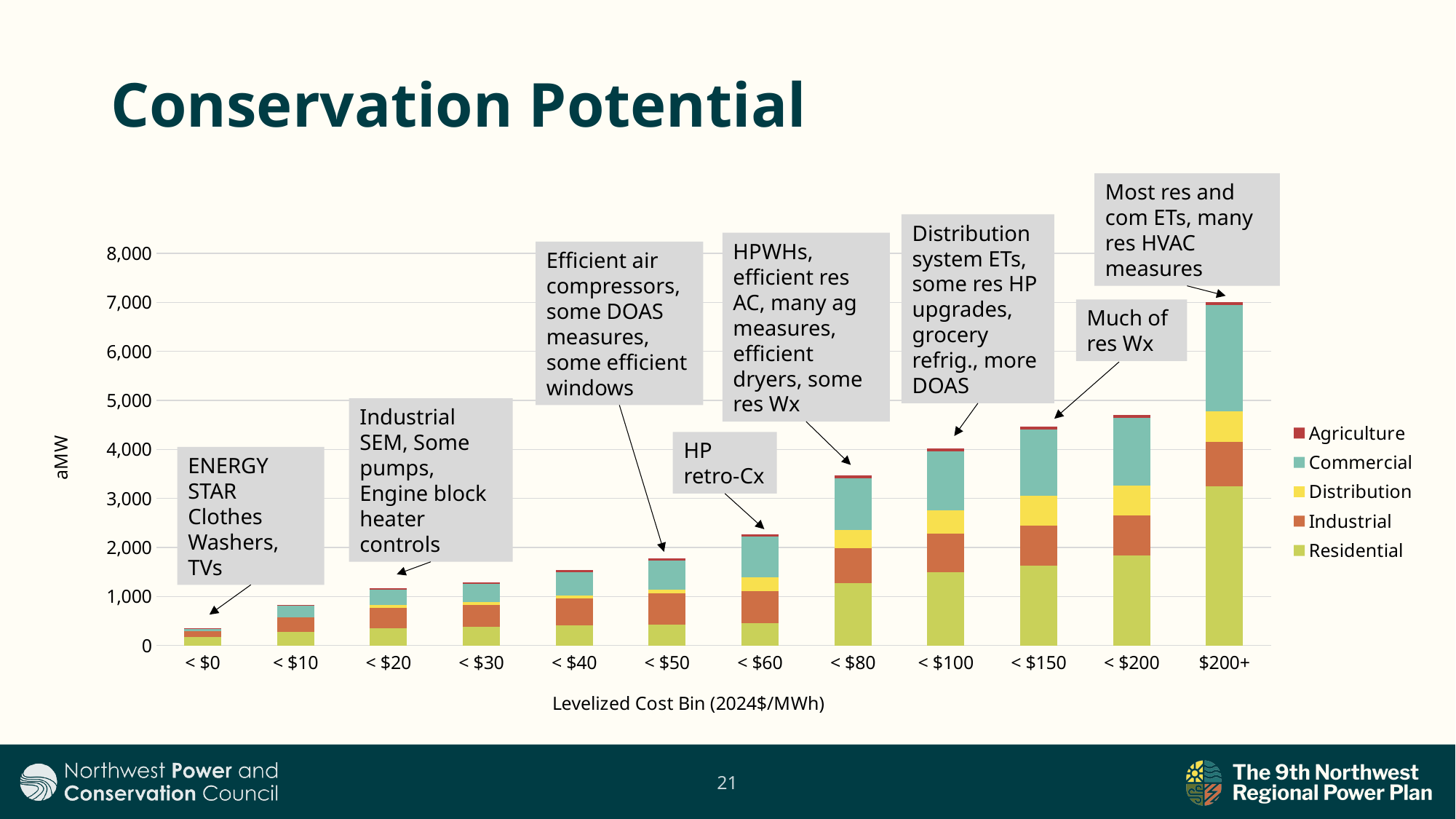
Is the total for the < $0 bin greater or less than 1,000 aMW? less Which series is shown at the bottom of each stacked bar? Residential How many levelized cost bins are shown on the x axis? 12 Which bin has a larger total, < $60 or < $80? < $80 Is the total for the < $80 bin greater or less than 3,000 aMW? greater How many series does the legend list? 5 What is the label on the y axis? aMW Which cost bin has the tallest stacked bar? $200+ Which cost bin has the shortest stacked bar? < $0 Is the total for the $200+ bin greater or less than 6,000 aMW? greater Do the stacked bar totals rise or fall as the levelized cost bin increases along the x axis? Rise What kind of chart is shown on the slide? Stacked bar chart